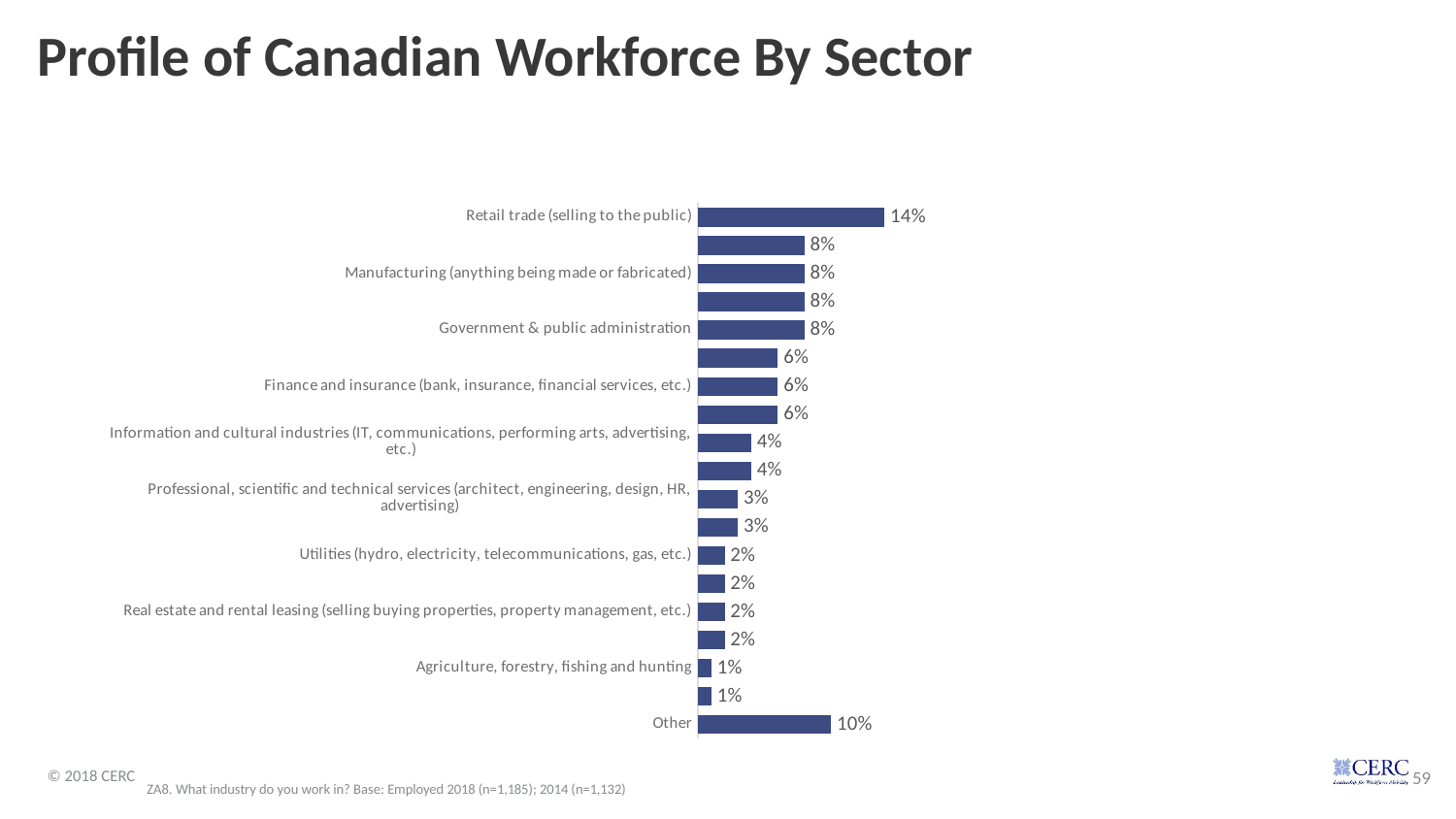
Which is larger, the value for Information and cultural industries or the value for Professional, scientific and technical services? Information and cultural industries What percentage of the Canadian workforce is in Retail trade (selling to the public)? 14% What kind of chart is shown on the slide? Bar chart What is the difference between the value for Retail trade (selling to the public) and the value for Other? 4 percentage points What is the value for Finance and insurance (bank, insurance, financial services, etc.)? 6% What is the value for Utilities (hydro, electricity, telecommunications, gas, etc.)? 2% What is the value for the Other category? 10% What is the title of the chart on the slide? Profile of Canadian Workforce By Sector What is the value for Agriculture, forestry, fishing and hunting? 1% What is the value for Manufacturing (anything being made or fabricated)? 8% What is the value for Government & public administration? 8% Which sector has the highest share of the Canadian workforce? Retail trade (selling to the public)